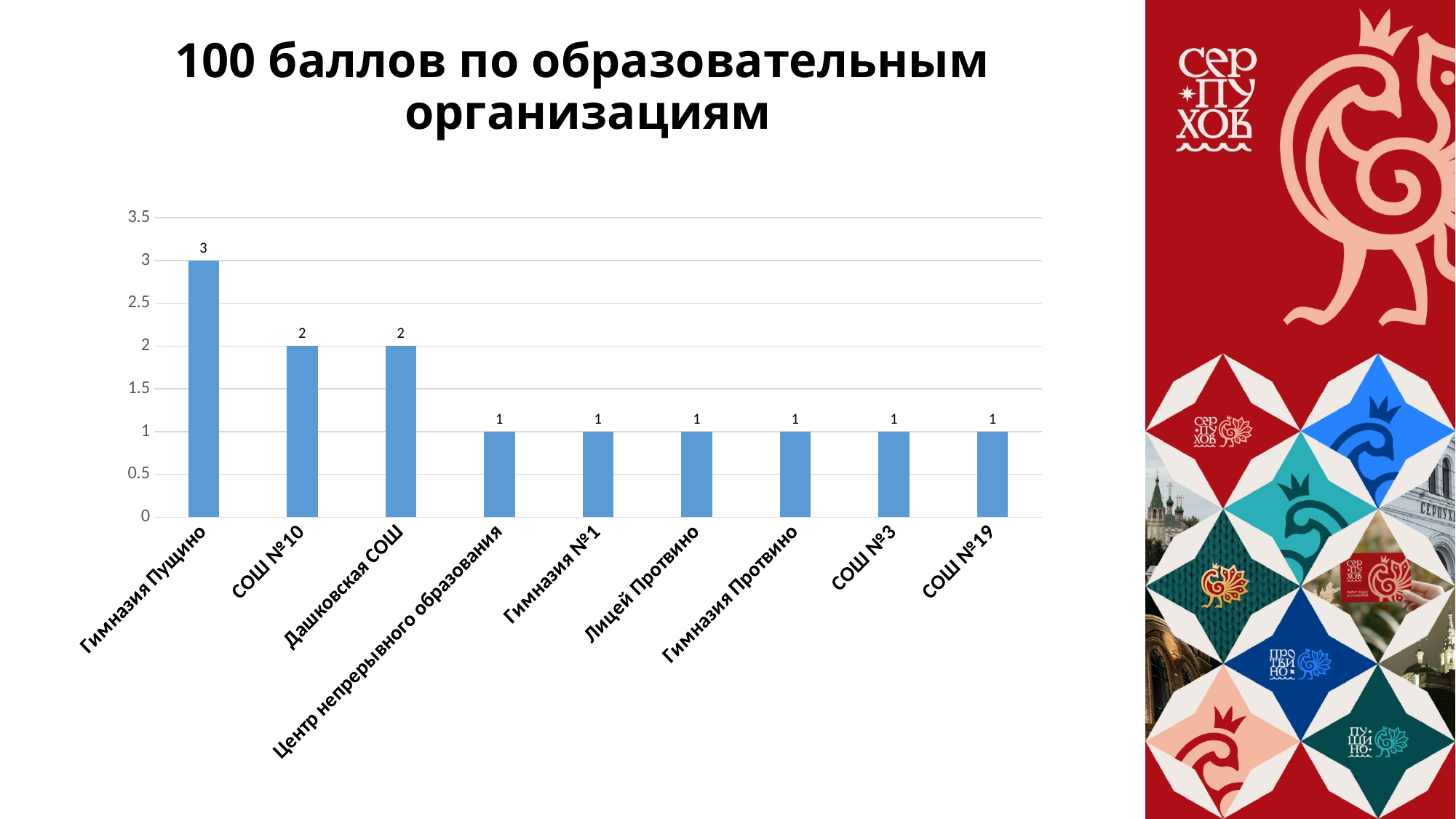
Which is larger, the value for СОШ №10 or the value for СОШ №3? СОШ №10 What is the value for Лицей Протвино? 1 How many categories are shown on the x axis? 9 What is the value for СОШ №10? 2 What is the title of the slide? 100 баллов по образовательным организациям What is the value for Гимназия Пущино? 3 Is the value for Гимназия Пущино greater or less than 2.5? greater What is the highest value shown on the vertical axis? 3.5 Do the values rise or fall from left to right along the x axis? fall What is the difference between the values for Гимназия Пущино and Дашковская СОШ? 1 What kind of chart is shown on the slide? bar chart Which category has the highest value? Гимназия Пущино